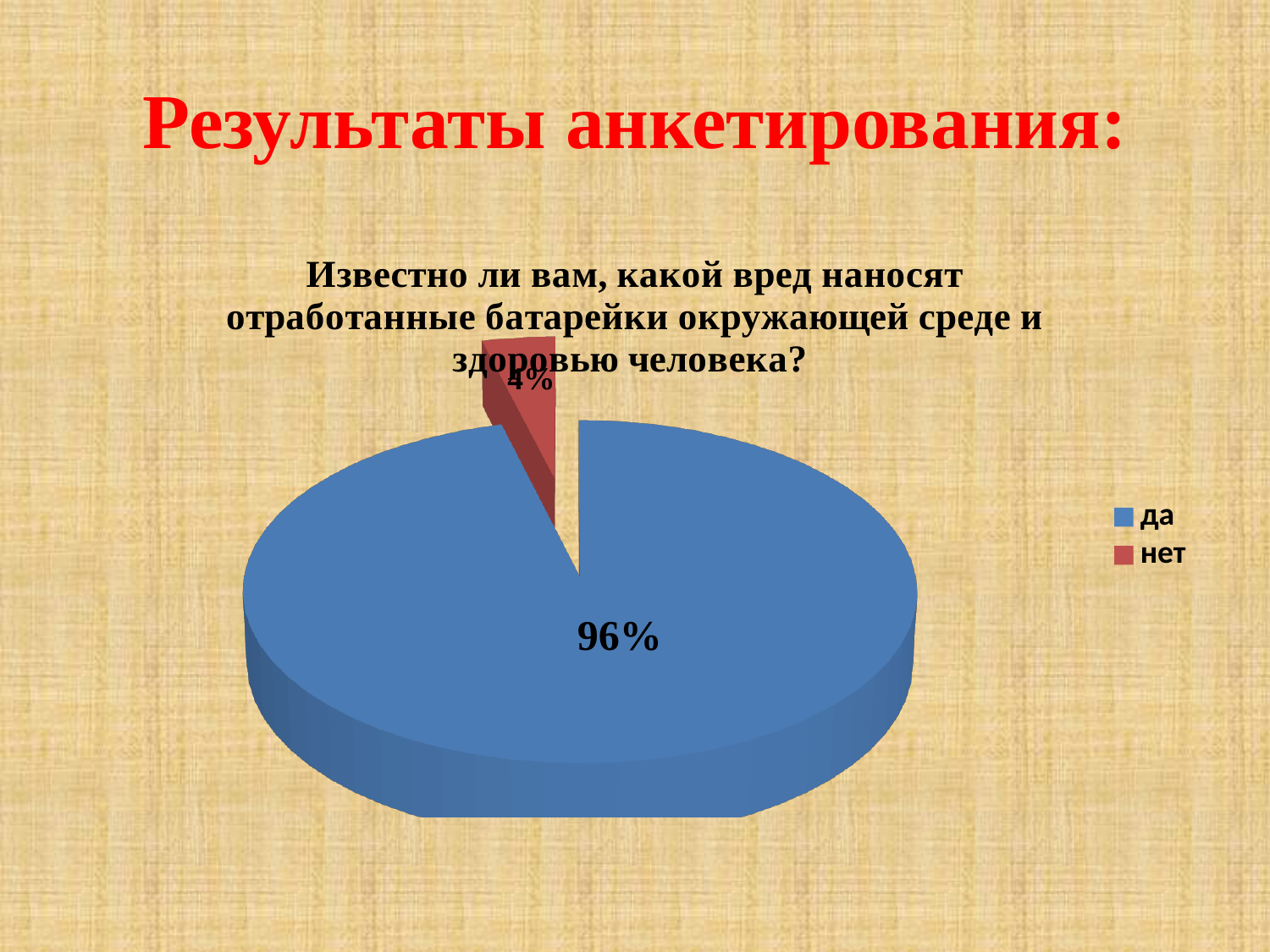
What is the difference in percentage points between "да" and "нет"? 92 What share of the pie does "нет" take? 4% What kind of chart is shown on the slide? pie chart Which category has the largest slice of the pie? да Which category has the smallest slice of the pie? нет What colour is the slice for "нет"? red What is the title of the chart? Известно ли вам, какой вред наносят отработанные батарейки окружающей среде и здоровью человека? What share of the pie does "да" take? 96% How many entries does the legend list? 2 How many categories does the pie chart have? 2 Which is larger, the slice for "да" or the slice for "нет"? да